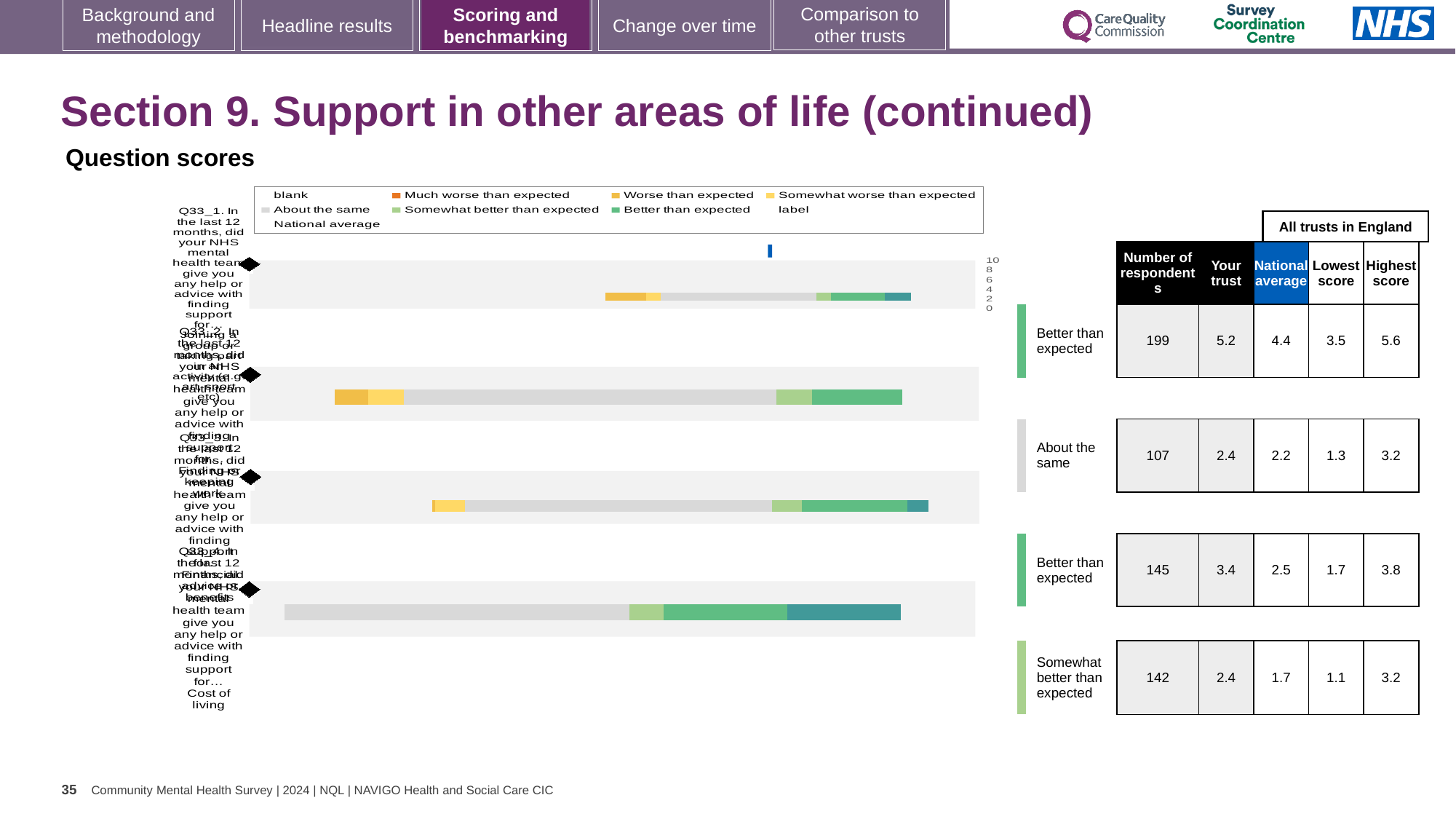
Which question's bar has the largest 'Worse than expected' segment in the 'Question scores' chart? Q33_1 What kind of chart is shown under 'Question scores'? bar chart How many entries does the legend of the 'Question scores' chart list? 9 In the 'Question scores' chart legend, what colour represents 'Much worse than expected'? orange How many bars (questions) are plotted in the 'Question scores' chart? 4 In the 'Question scores' chart legend, what colour represents 'About the same'? grey